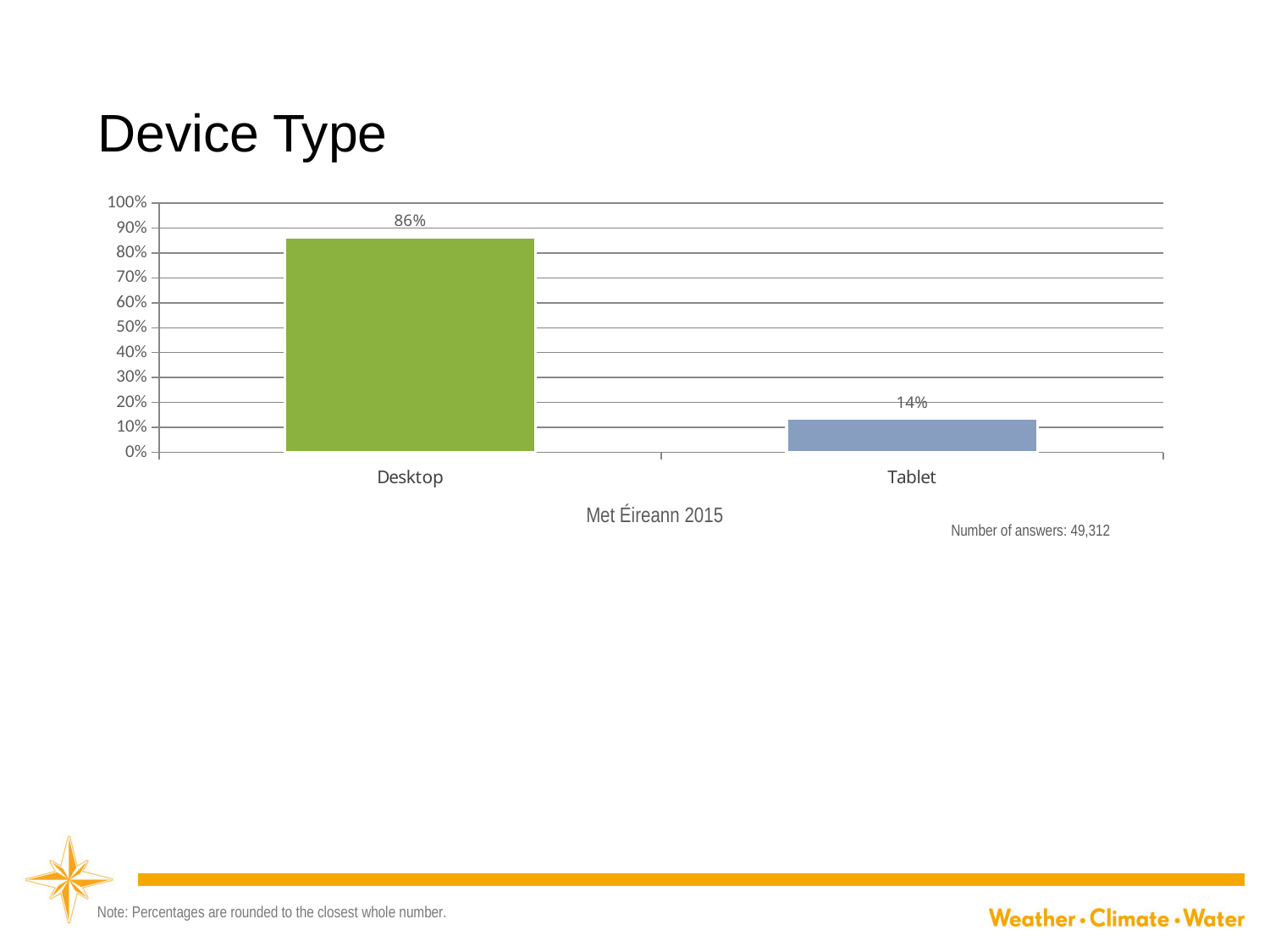
How many device type categories are shown in the chart? 2 Is the value for Tablet greater or less than 20%? less What is the difference between the Desktop and Tablet values? 72% Which device type has the highest value? Desktop What is the value for Desktop? 86% What kind of chart is shown on the slide? Bar chart Which is larger, the value for Desktop or the value for Tablet? Desktop What is the value for Tablet? 14% Is the value for Desktop greater or less than 80%? greater What is the total of the Desktop and Tablet values? 100% What is the title of the slide? Device Type Which device type has the lowest value? Tablet